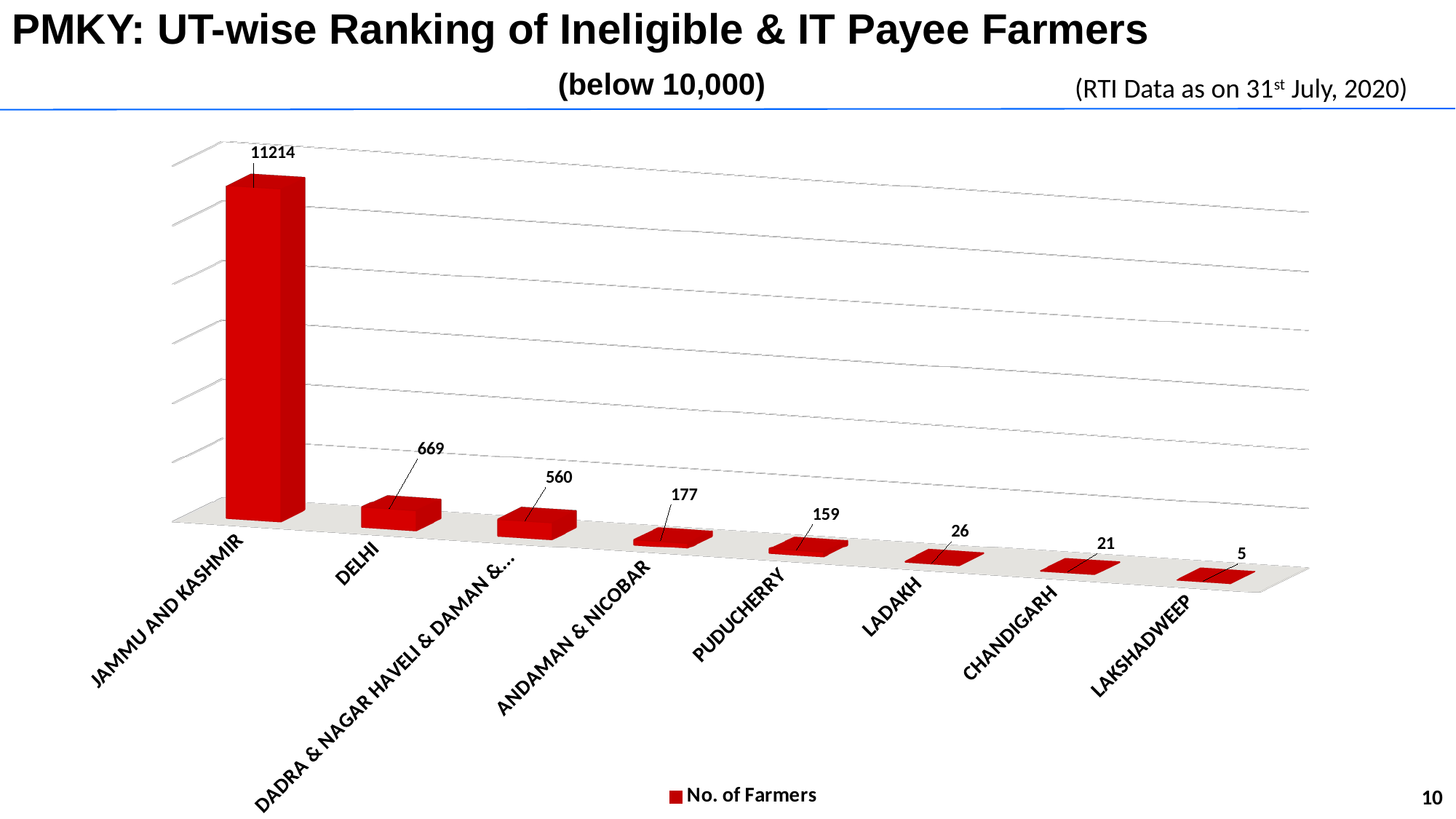
What is the number of farmers for Puducherry? 159 What is the number of farmers for Delhi? 669 What kind of chart is shown on the slide? Bar chart Do the values rise or fall from left to right along the x axis? Fall Which UT has the lowest number of farmers? Lakshadweep What is the number of farmers for Lakshadweep? 5 How many UTs are shown on the chart? 8 Which UT has the highest number of farmers? Jammu and Kashmir How many series does the legend list? 1 Which has more farmers, Ladakh or Chandigarh? Ladakh What is the number of farmers for Jammu and Kashmir? 11214 What is the difference between the number of farmers for Delhi and Andaman & Nicobar? 492